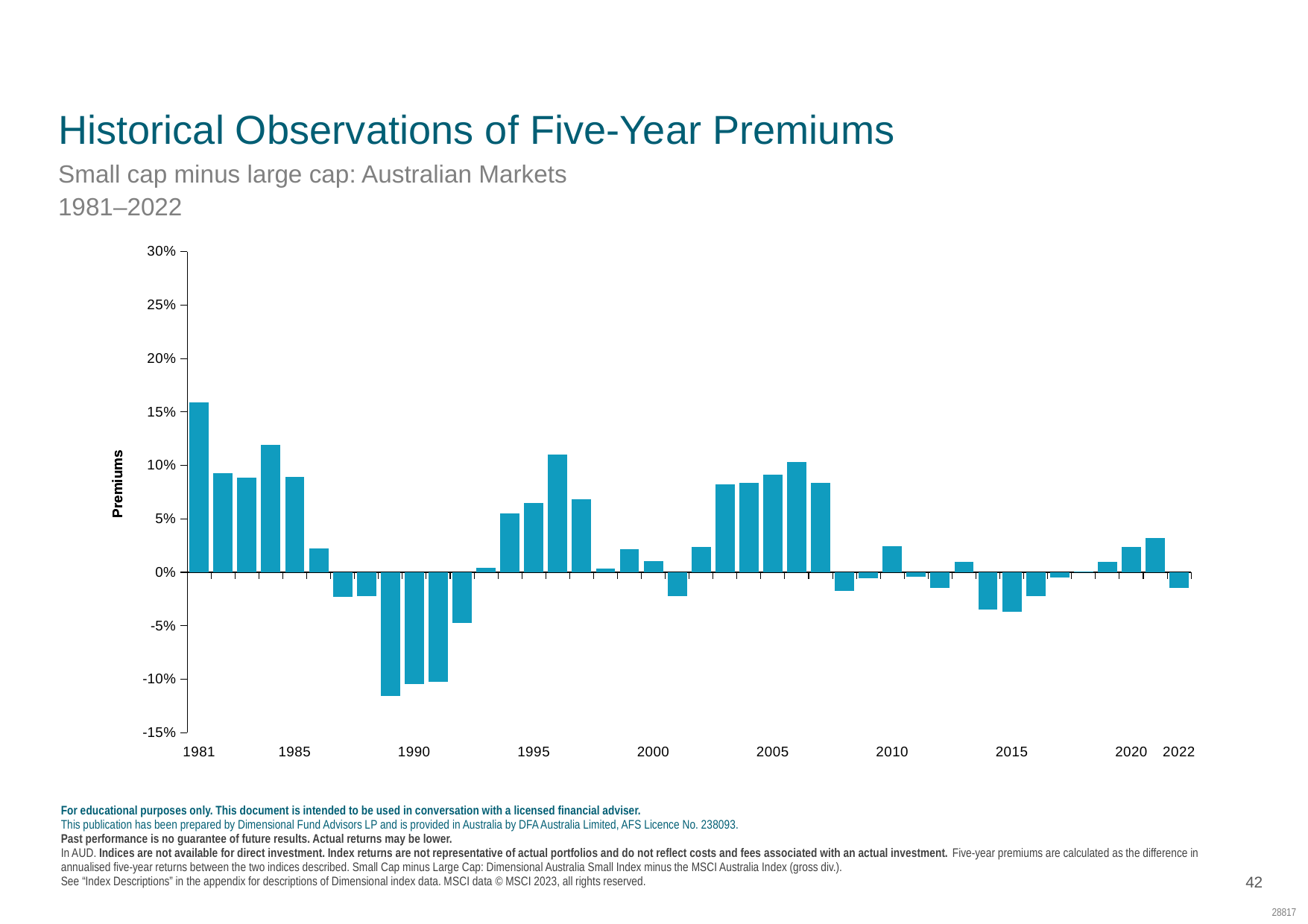
Which year has the larger five-year premium, 1981 or 1985? 1981 What is the label on the vertical axis of the chart? Premiums Is the value for 1990 greater or less than -5%? less Is the value for 2020 greater or less than 0%? greater Is the value for 2015 greater or less than 0%? less How many years (bars) are plotted in the chart? 42 Which year has the larger five-year premium, 1990 or 2000? 2000 Which year has the highest five-year premium in the chart? 1981 Which year has the lowest five-year premium in the chart? 1989 What kind of chart is shown on the slide? Bar chart